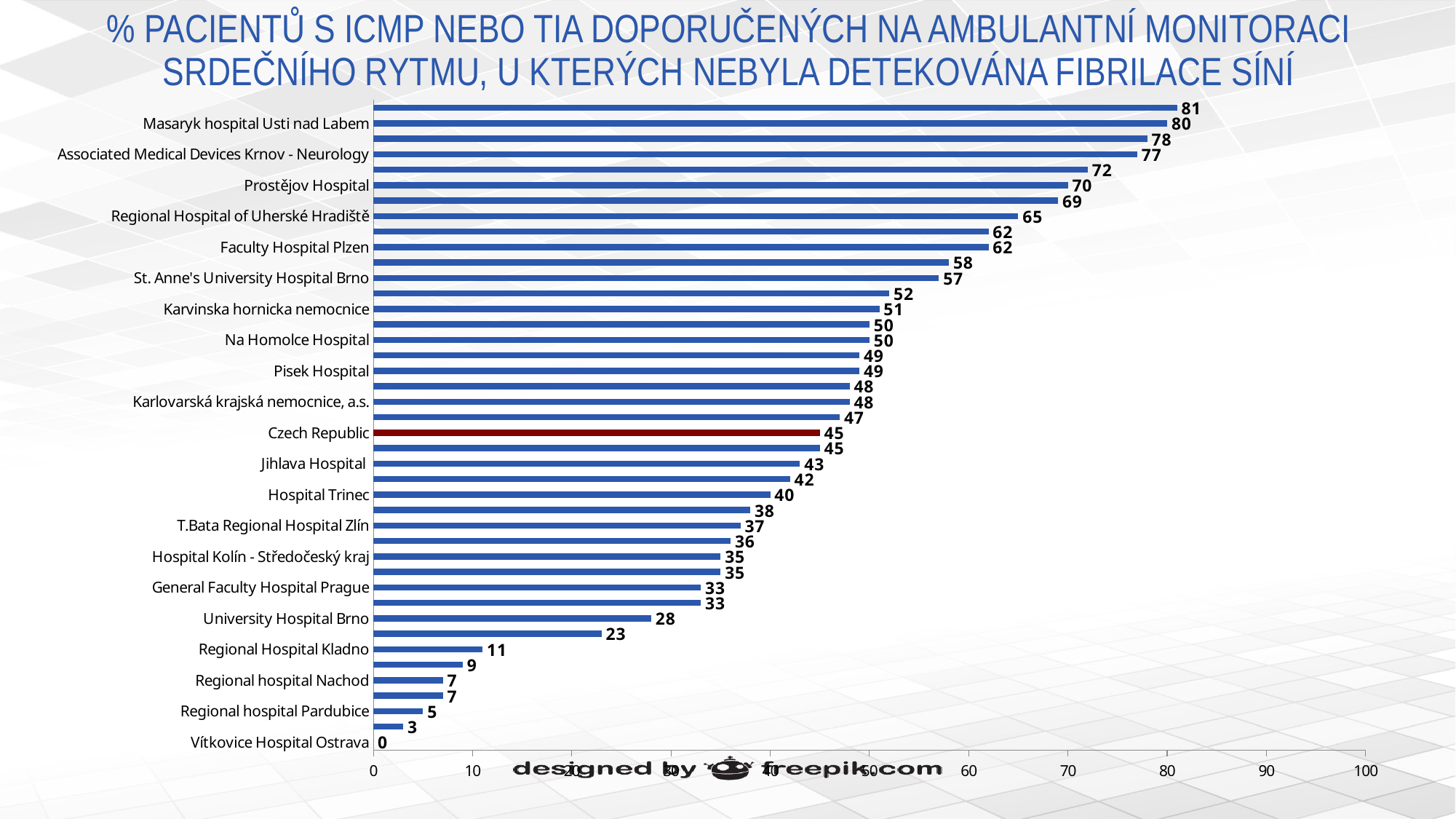
What is the difference between the values for Masaryk hospital Usti nad Labem and Czech Republic? 35 What kind of chart is shown on the slide? bar chart What colour is the bar for Czech Republic? red What is the value for Masaryk hospital Usti nad Labem? 80 What is the value for Regional Hospital Kladno? 11 What is the value for Vítkovice Hospital Ostrava? 0 What is the highest value shown on the chart? 81 Which labelled category has the lowest value? Vítkovice Hospital Ostrava Is the value for Faculty Hospital Plzen greater or less than 50? greater What is the value for Na Homolce Hospital? 50 What is the value for Czech Republic? 45 Which is larger, the value for Pisek Hospital or the value for Jihlava Hospital? Pisek Hospital